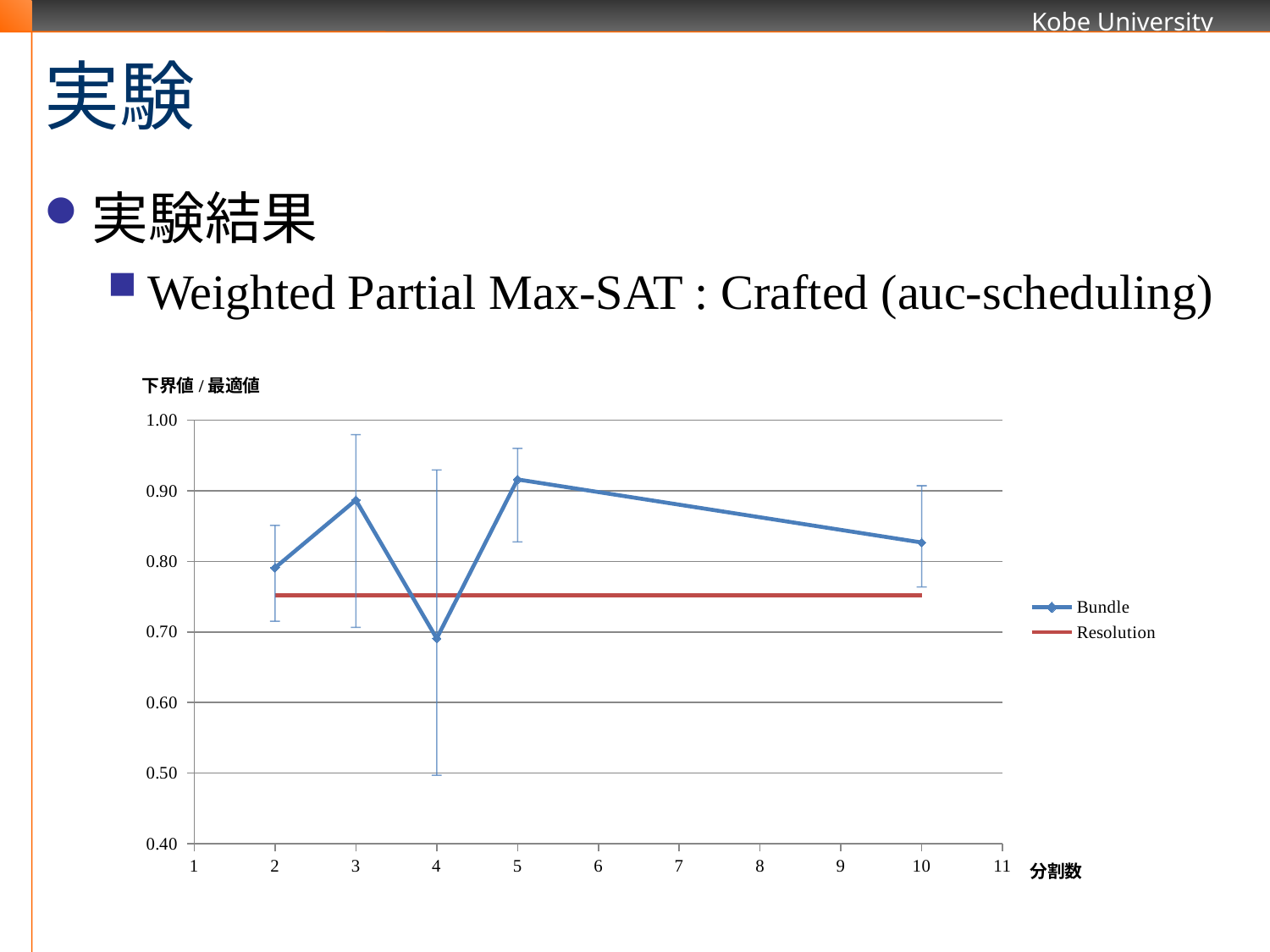
Is the Resolution line greater or less than 0.80? less Is the Bundle value at 分割数 10 greater or less than 0.80? greater At 分割数 4, which is larger: the Bundle value or the Resolution value? Resolution Is the Bundle value at 分割数 5 greater or less than 0.90? greater What is the label on the x axis of the chart? 分割数 What kind of chart is shown on the slide? line chart How many series does the legend list? 2 At which 分割数 value does the Bundle series reach its highest point? 5 What are the two series named in the legend? Bundle and Resolution How many data points are plotted for the Bundle series? 5 At which 分割数 value does the Bundle series reach its lowest point? 4